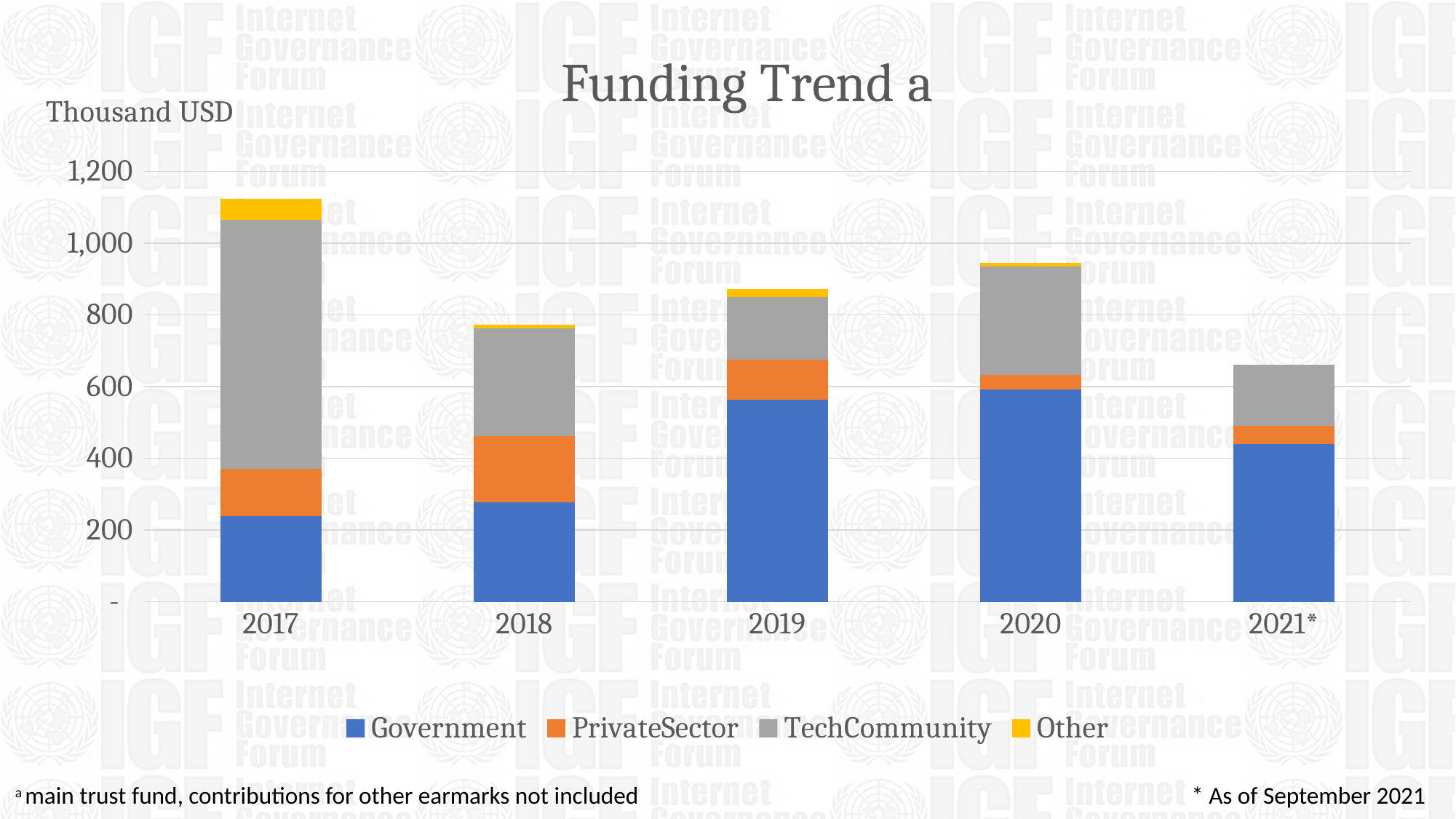
How many series does the legend list? 4 How many years are shown on the x axis of the chart? 5 What unit is shown for the vertical axis of the chart? Thousand USD Which year has the lowest total funding bar? 2021* Is the Government contribution in 2017 greater or less than 400? less Which year has the highest total funding bar? 2017 Is the total funding for 2021* greater or less than 800? less Is the Government contribution in 2019 greater or less than 400? greater What kind of chart is shown on the slide? Stacked bar chart Which is larger, the total funding bar for 2018 or for 2020? 2020 Does the Government contribution rise or fall from 2017 to 2019? rise